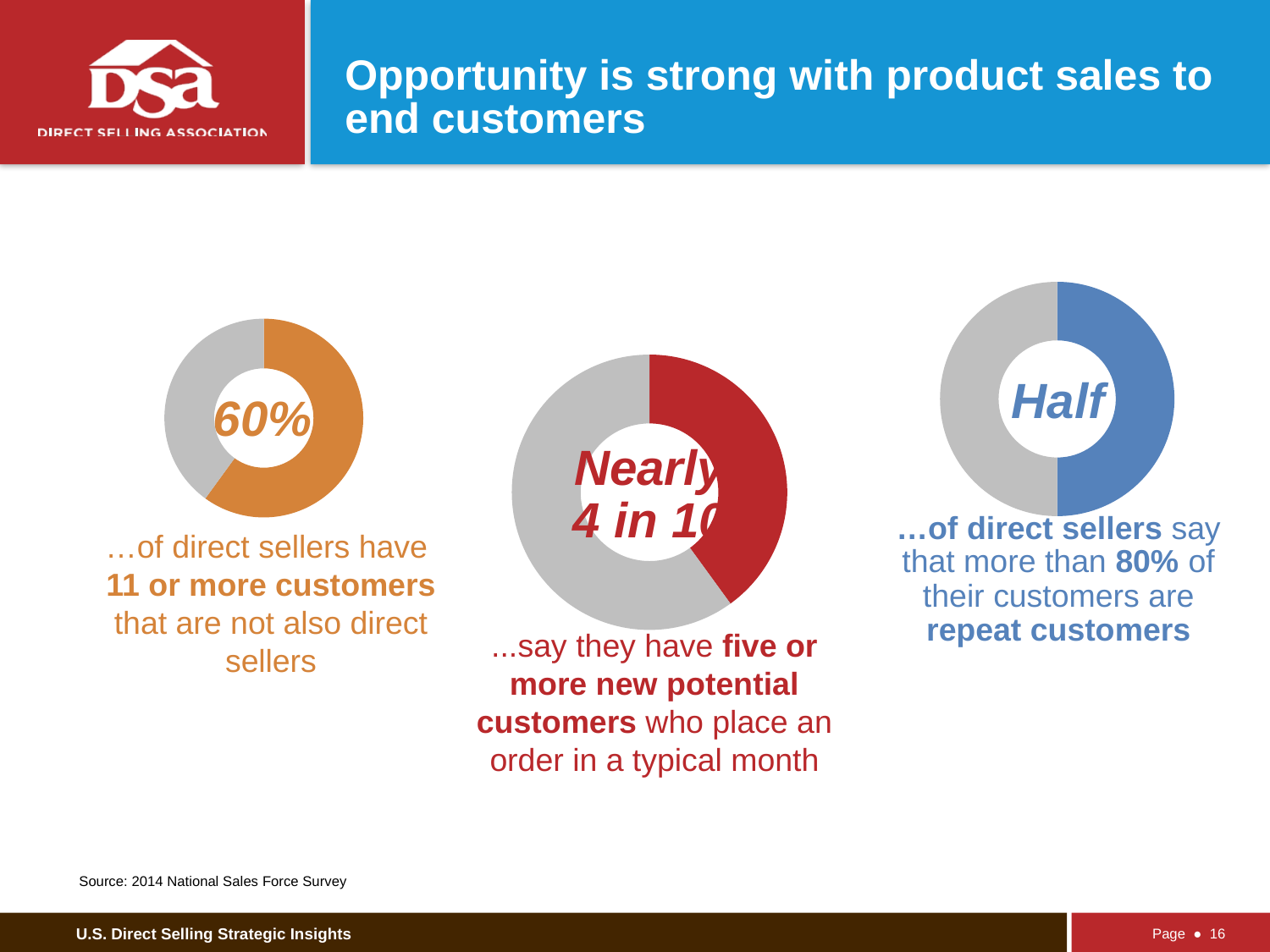
Of the three donut charts, which one shows the largest highlighted share? The left chart (60%) What colour is the highlighted segment of the right donut chart? Blue Of the three donut charts, which one shows the smallest highlighted share? The middle chart (Nearly 4 in 10) In the right chart, what share of direct sellers say that more than 80% of their customers are repeat customers? Half In the left chart, what percentage of direct sellers have 11 or more customers that are not also direct sellers? 60% Is the highlighted red share in the middle chart greater or less than 50%? less How many donut charts are shown on the slide? 3 In the middle chart, what share of direct sellers say they have five or more new potential customers who place an order in a typical month? Nearly 4 in 10 Is the highlighted orange share in the left chart greater or less than 50%? greater What kind of chart is used on the left of the slide to show the share of direct sellers with 11 or more customers? Donut (pie) chart Which is larger: the highlighted share in the left chart or the highlighted share in the right chart? The left chart (60%) In the left chart, what share of the donut is the grey (remaining) portion? 40%